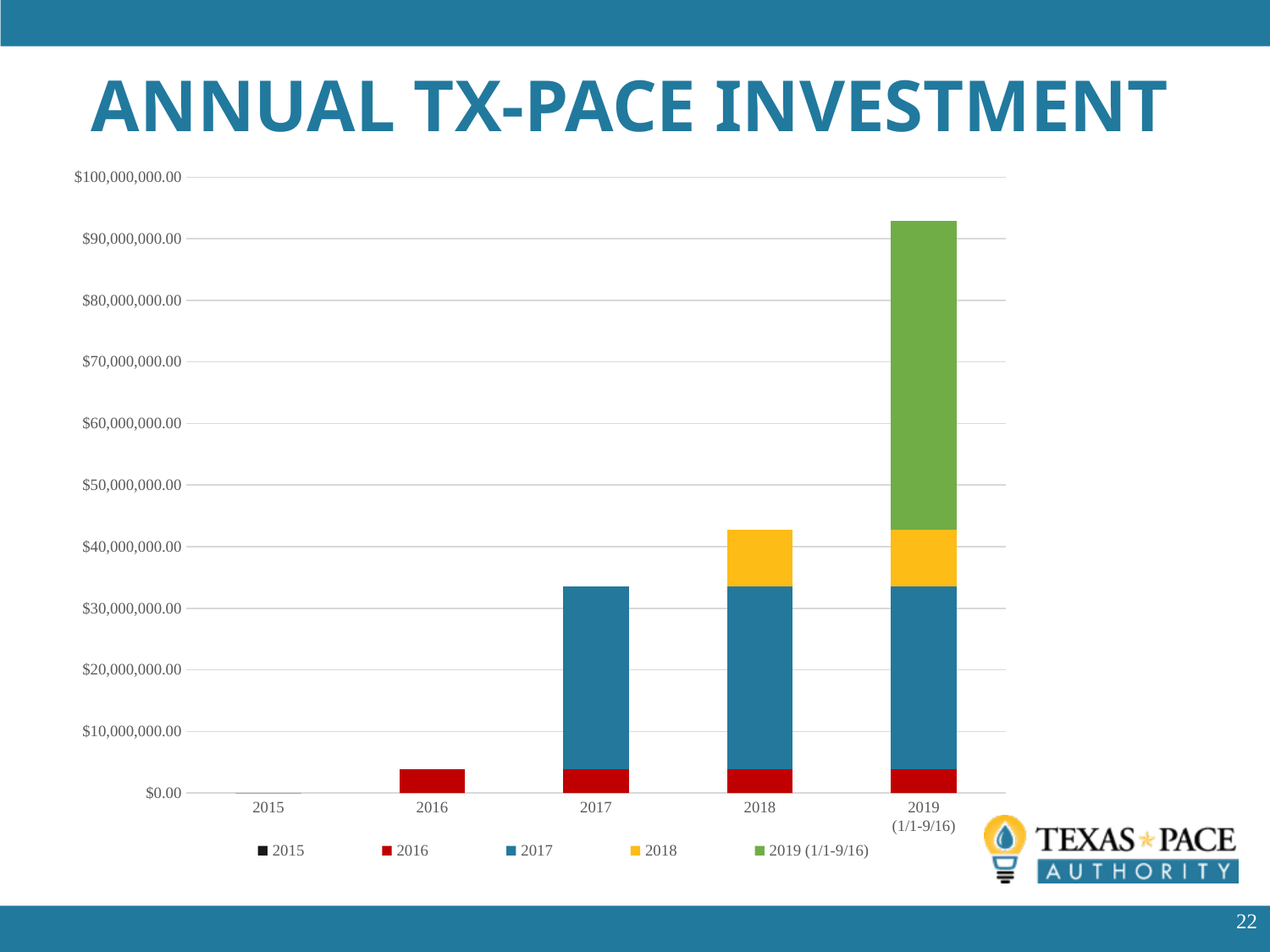
Which category has the tallest bar? 2019 (1/1-9/16) Is the total bar for 2019 (1/1-9/16) greater or less than $80,000,000.00? greater Which category has the shortest bar? 2015 Is the bar for 2016 greater or less than $10,000,000.00? less How many series does the legend list? 5 Which is larger, the total bar for 2018 or the total bar for 2017? 2018 What kind of chart is shown on the slide? Stacked bar chart How many categories are shown along the x axis? 5 Is the total bar for 2018 greater or less than $40,000,000.00? greater Do the bar totals rise or fall from 2015 to 2019 (1/1-9/16)? rise What is the title of the chart? ANNUAL TX-PACE INVESTMENT